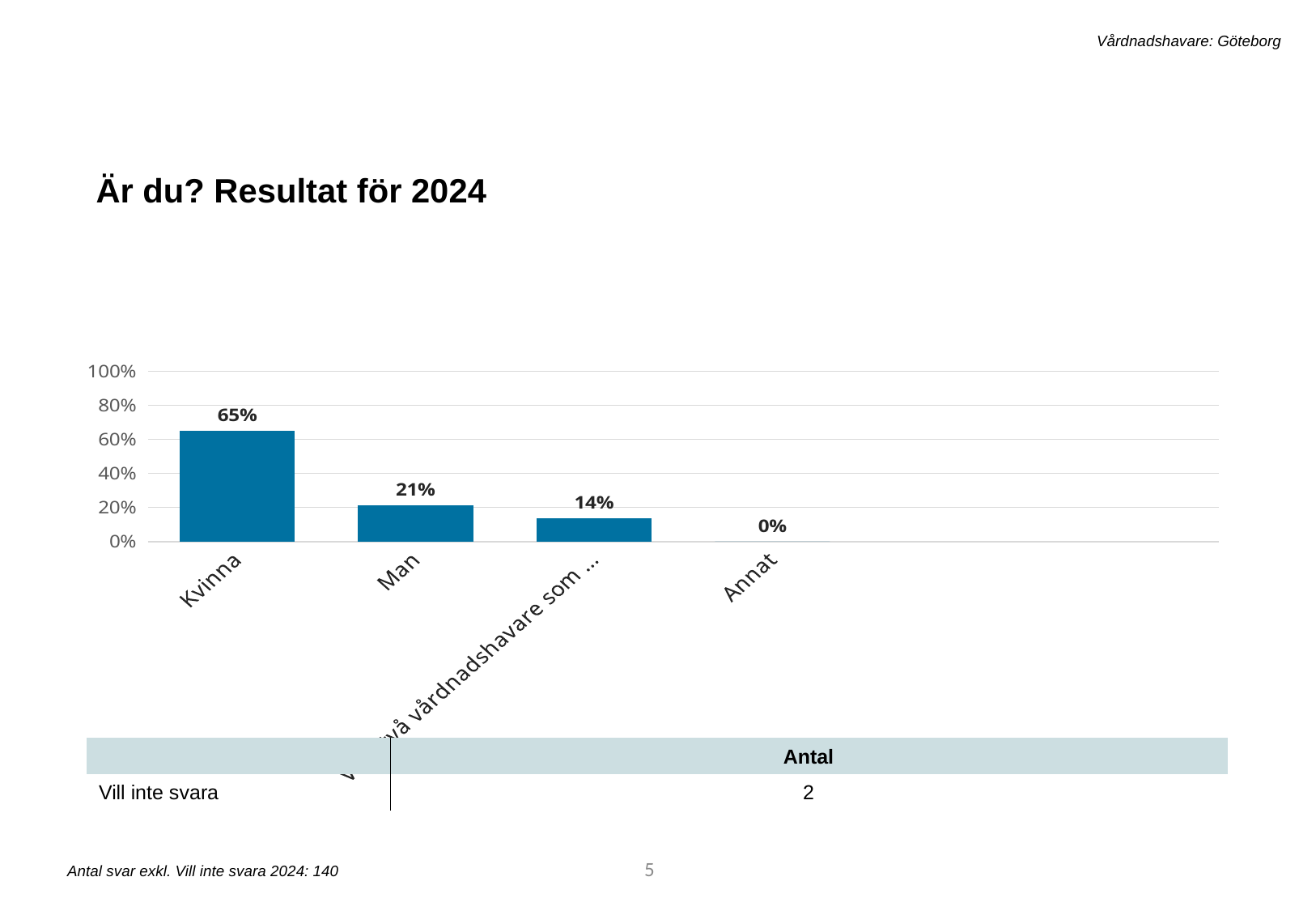
Is the value for Kvinna greater or less than 60%? greater How many categories are shown on the x axis? 4 What is the title of the slide containing the chart? Är du? Resultat för 2024 Which category has the lowest value? Annat What is the value for Kvinna? 65% Which is larger, the value for Man or the value for Annat? Man What kind of chart is shown on the slide? bar chart What is the value for Man? 21% What is the difference between the values for Kvinna and Man? 44% Which category has the highest value? Kvinna Do the values rise or fall from left to right along the x axis? fall What is the value for Annat? 0%